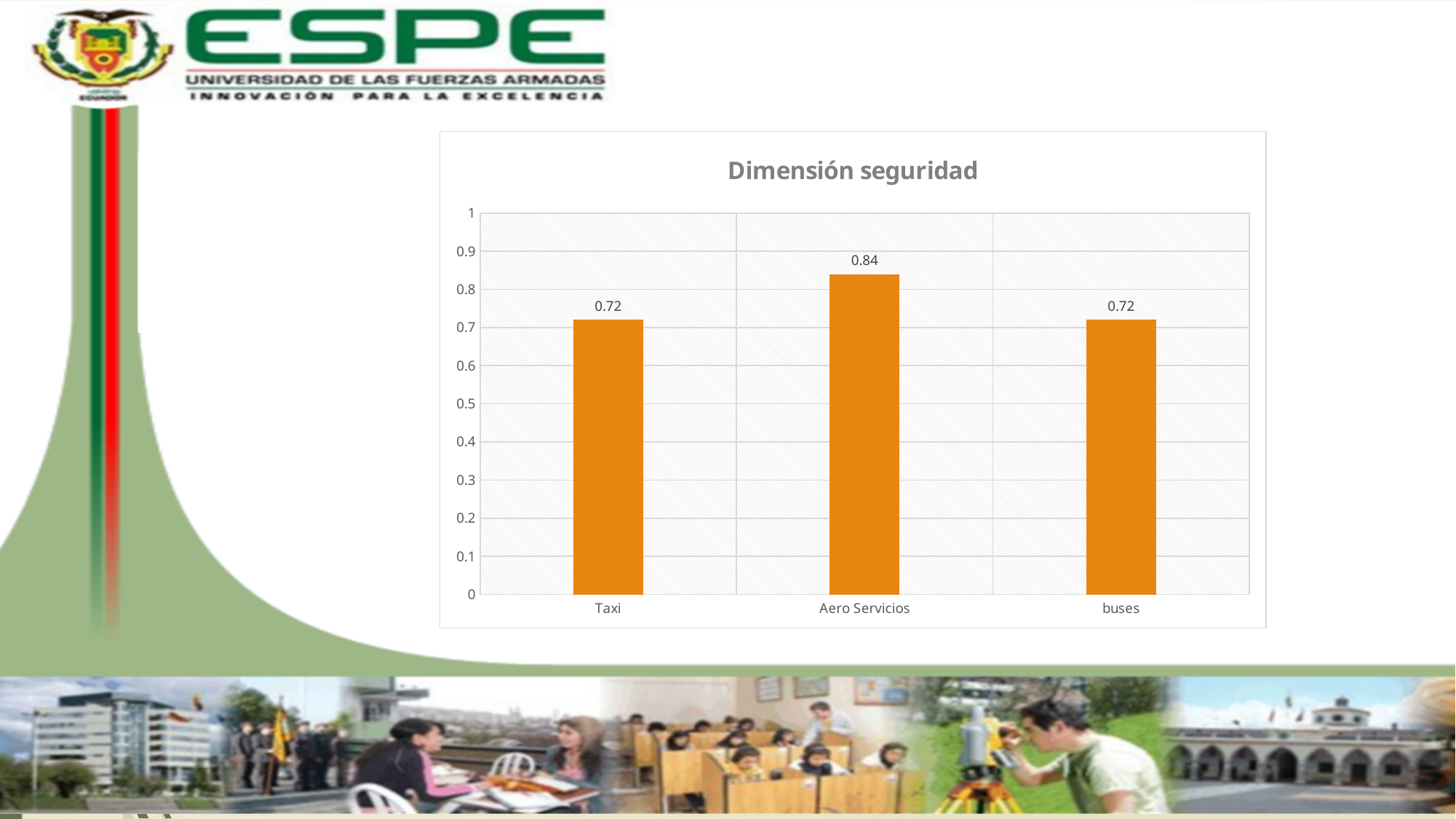
What is the value for buses? 0.72 Is the value for Aero Servicios greater or less than 0.8? greater What is the title of the chart? Dimensión seguridad What is the value for Aero Servicios? 0.84 Is the value for Taxi greater or less than 0.8? less What is the difference between the values for Aero Servicios and Taxi? 0.12 What is the value for Taxi? 0.72 How many categories are shown on the x axis? 3 What colour are the bars in the chart? orange What kind of chart is shown on the slide? bar chart Which is larger, the value for Aero Servicios or the value for buses? Aero Servicios Which category has the highest value? Aero Servicios